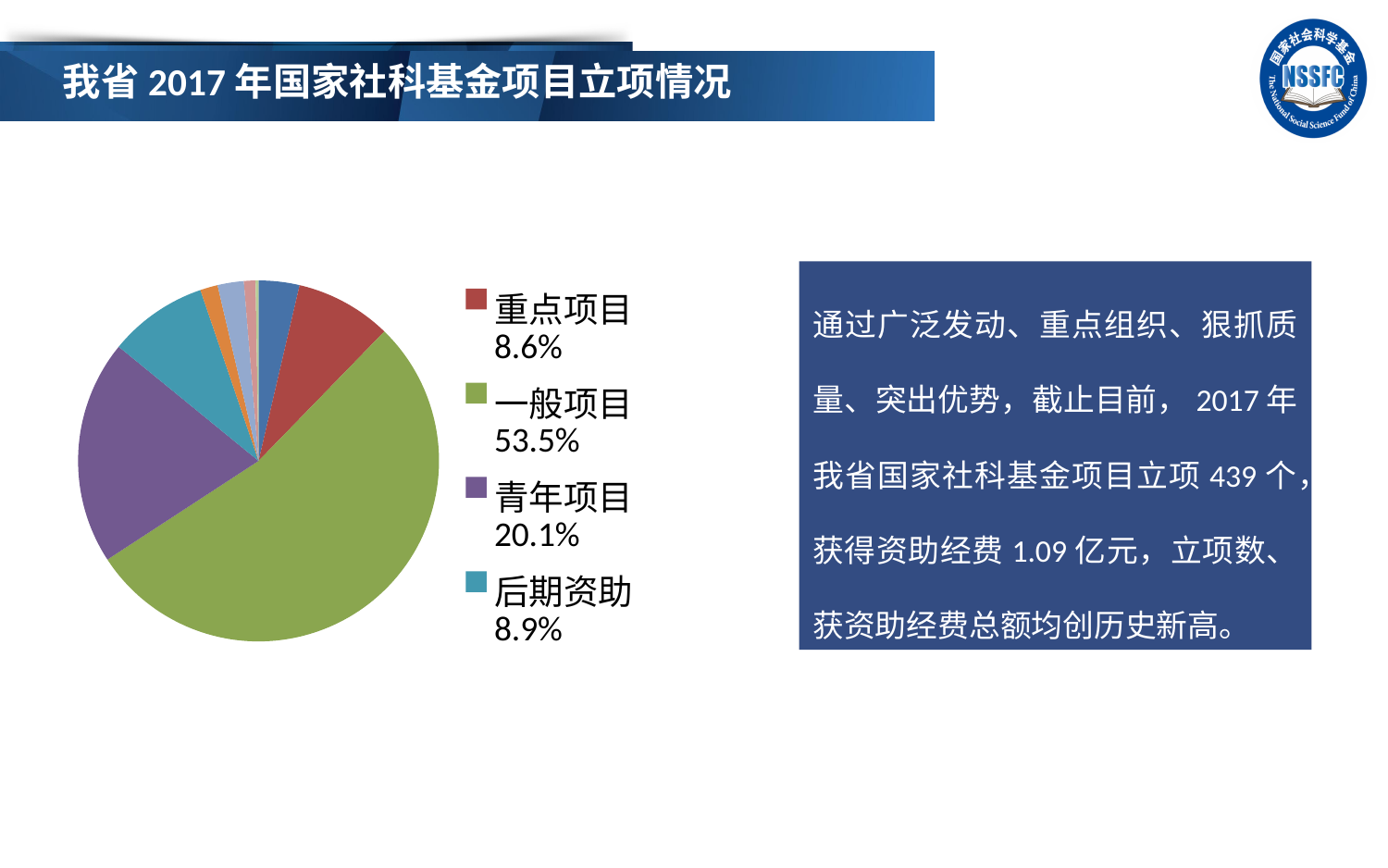
How many entries does the chart legend list? 4 What is the combined share of 重点项目 and 青年项目? 28.7% Is the share of 一般项目 greater or less than 50%? greater What percentage is shown for 青年项目 in the legend? 20.1% What share is shown for 重点项目? 8.6% Which labelled category has the smallest share of the pie? 重点项目 What type of chart is shown on the slide? pie chart What percentage does 后期资助 represent? 8.9% Which labelled category has the largest share of the pie? 一般项目 Which has the larger share, 重点项目 or 后期资助? 后期资助 What share of the pie does 一般项目 account for? 53.5% How many percentage points larger is the share of 一般项目 than that of 青年项目? 33.4%